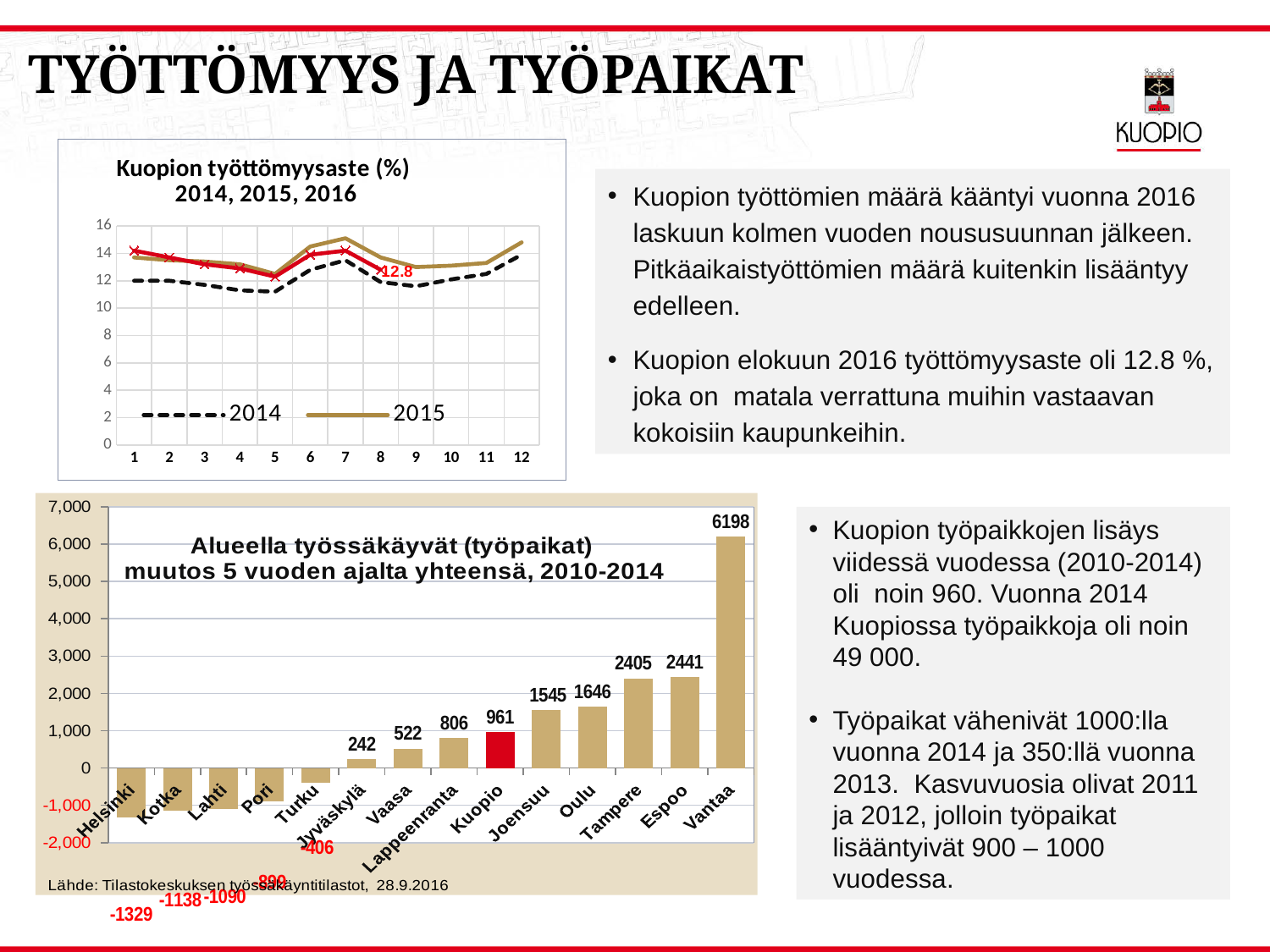
In the bottom-left bar chart, which city's bar is coloured red? Kuopio In the bottom-left bar chart, what is the difference between the values for Espoo and Tampere? 36 How many series does the legend of the top-left chart 'Kuopion työttömyysaste (%)' list? 2 In the top-left chart 'Kuopion työttömyysaste (%)', is the 2014 value at month 5 greater or less than 12? less How many cities are shown in the bottom-left bar chart? 14 In the top-left chart 'Kuopion työttömyysaste (%)', what value is labelled on the red line at month 8? 12.8 In the bottom-left bar chart, which is larger, the value for Oulu or the value for Joensuu? Oulu In the bottom-left bar chart, which city has the highest value? Vantaa In the bottom-left bar chart, is the value for Helsinki greater or less than -1,000? less In the bottom-left bar chart, what is the value for Vantaa? 6198 What kind of chart is the bottom-left chart titled 'Alueella työssäkäyvät (työpaikat) muutos 5 vuoden ajalta yhteensä, 2010-2014'? bar chart In the bottom-left bar chart, what is the value for Kuopio? 961